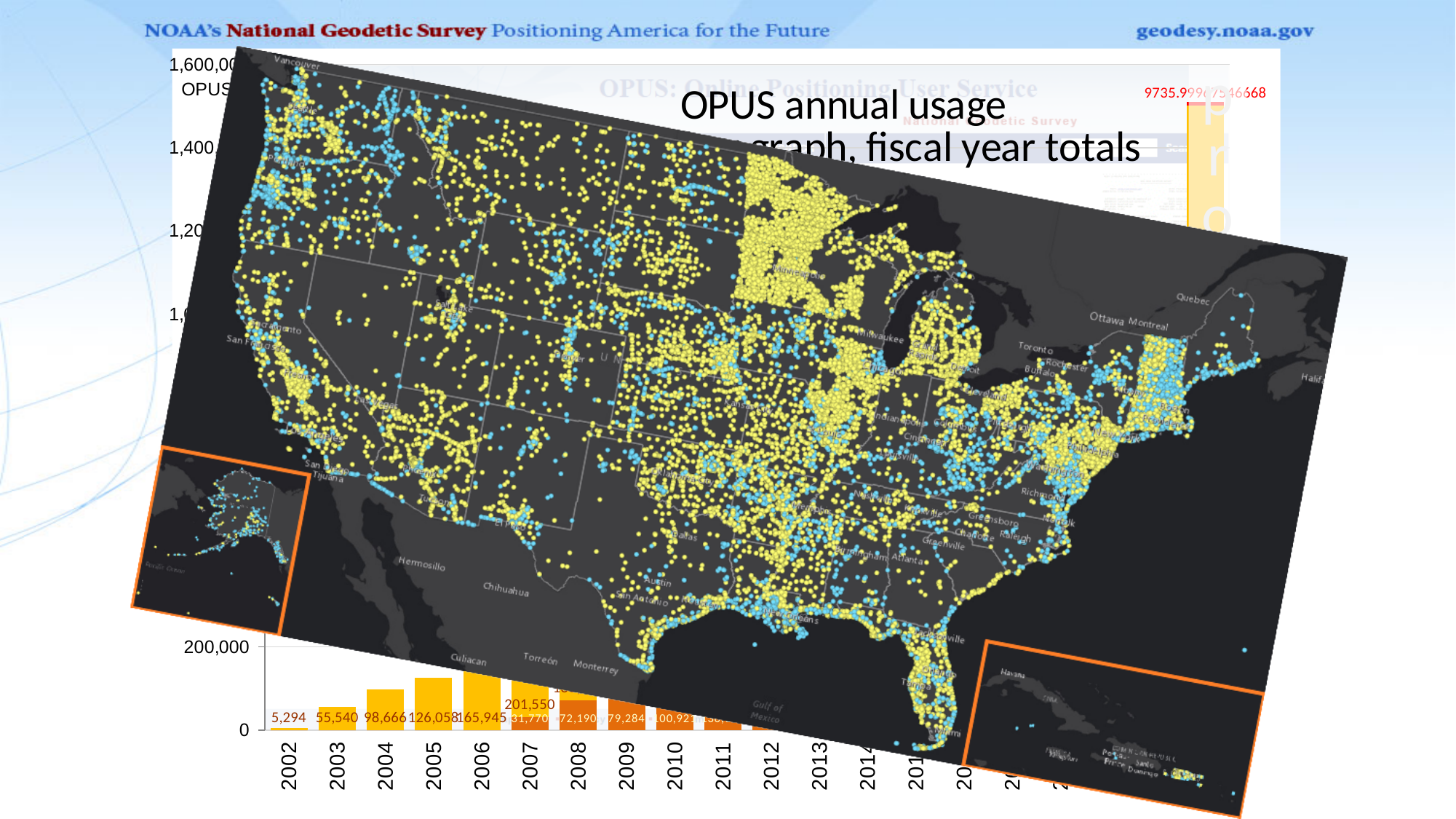
What is the value for 2005 in the OPUS annual usage graph? 126,058 In the OPUS annual usage graph, what is the difference between the values for 2006 and 2005? 39,887 In the OPUS annual usage graph, is the value for 2006 greater or less than 200,000? less What is the value for 2002 in the OPUS annual usage graph? 5,294 In the OPUS annual usage graph, what is the difference between the values for 2003 and 2002? 50,246 In the OPUS annual usage graph, which is larger, the value for 2003 or the value for 2005? 2005 What is the value for 2006 in the OPUS annual usage graph? 165,945 What is the value for 2003 in the OPUS annual usage graph? 55,540 What kind of chart is the OPUS annual usage graph? bar chart What is the value for 2004 in the OPUS annual usage graph? 98,666 In the OPUS annual usage graph, do the values rise or fall from 2002 to 2006? rise